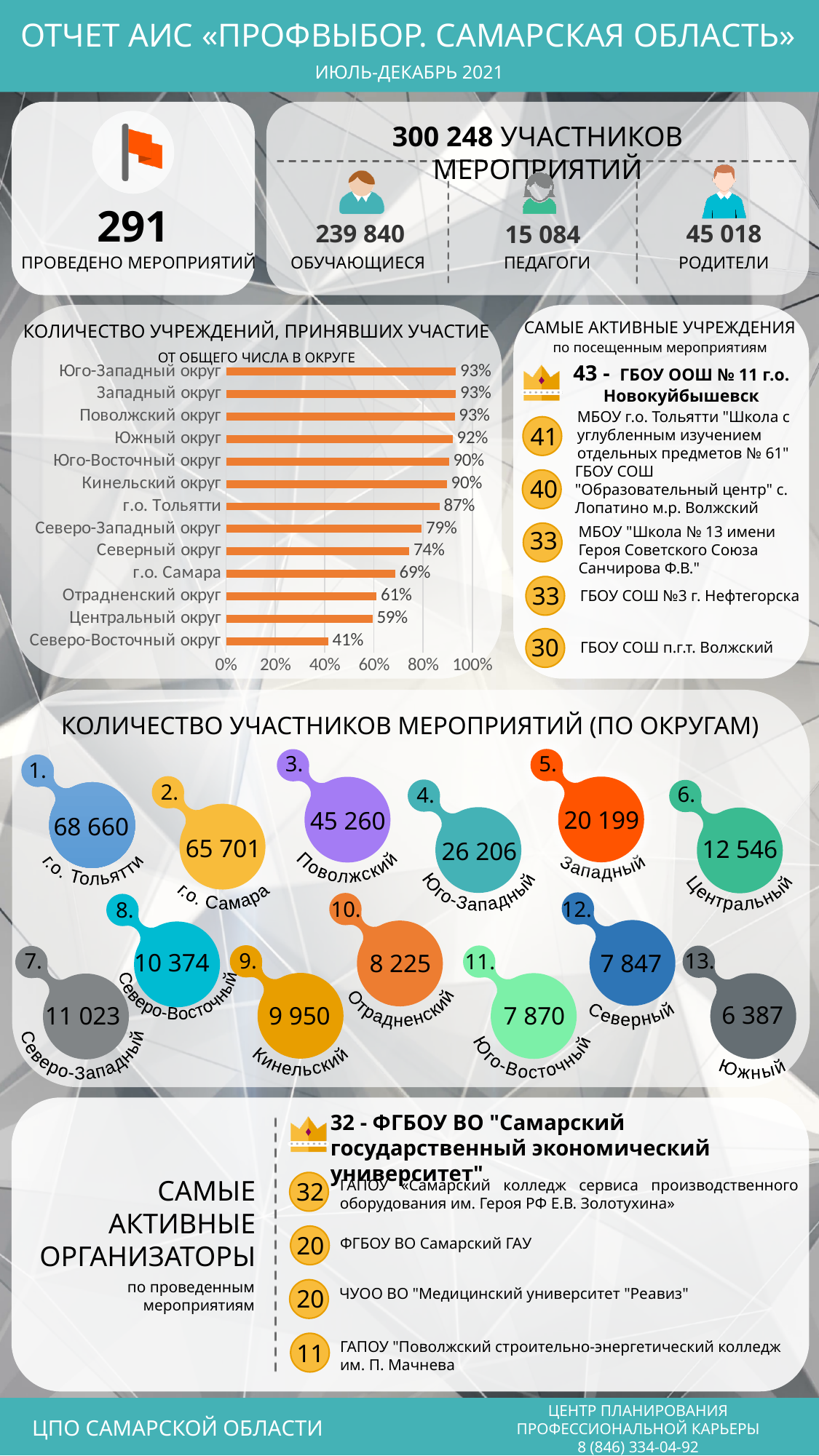
What is the value shown for Северо-Западный округ in the bar chart? 79% What is the value shown for г.о. Самара in the bar chart? 69% What is the highest tick label on the horizontal axis of the bar chart? 100% Which district has the lowest value in the bar chart? Северо-Восточный округ Which has the larger value in the bar chart, Северный округ or г.о. Самара? Северный округ What type of chart is used to show the share of institutions that took part by district? bar chart What is the value shown for Южный округ in the bar chart? 92% What is the value shown for Отрадненский округ in the bar chart? 61% How many districts are listed in the bar chart? 13 Do the bar values increase or decrease going from the top of the bar chart to the bottom? decrease What is the difference between the values for г.о. Тольятти and Центральный округ in the bar chart? 28 percentage points What is the difference between the value for Юго-Западный округ and the value for Северо-Восточный округ in the bar chart? 52 percentage points